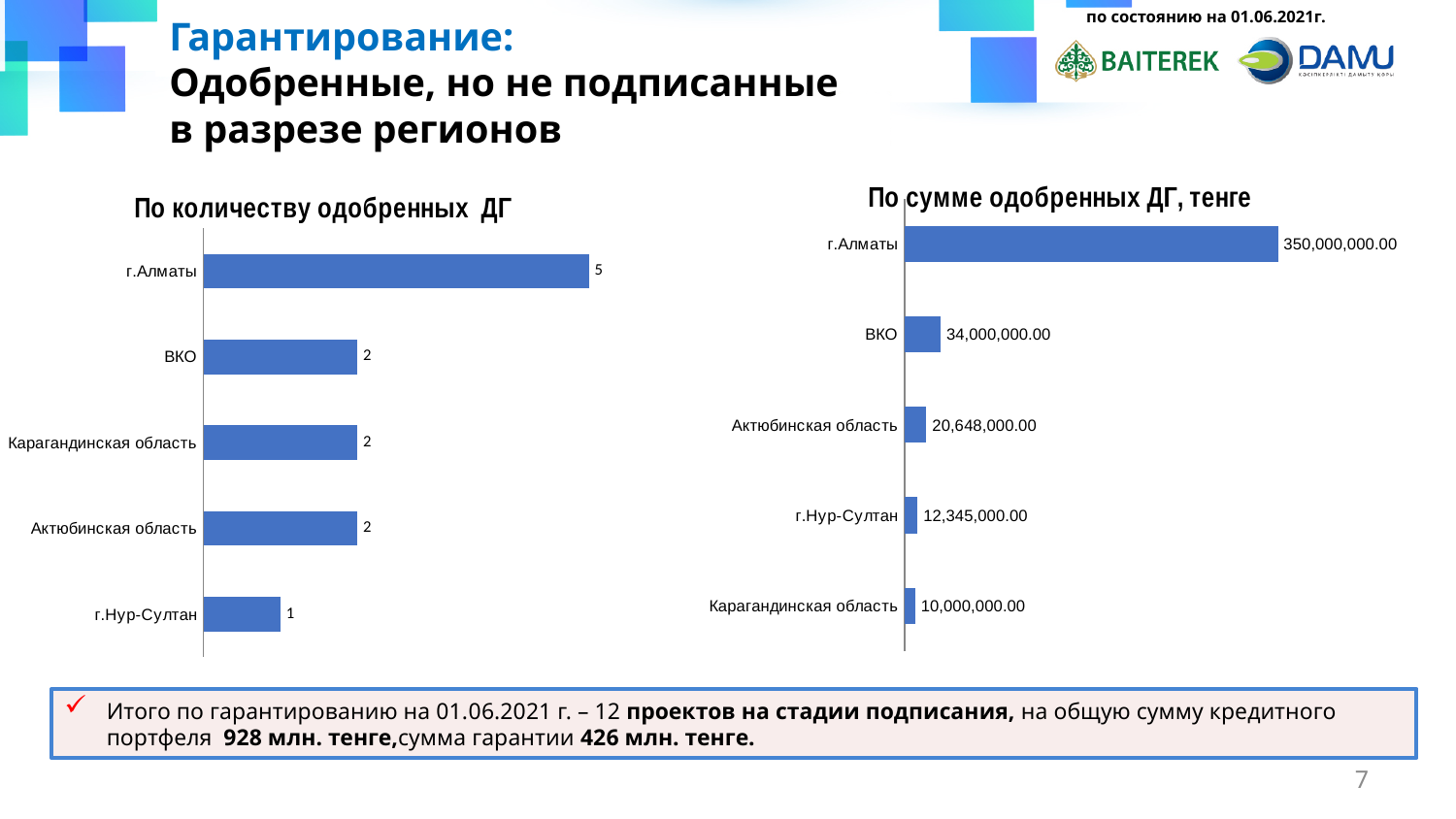
What type of chart is "По сумме одобренных ДГ, тенге"? Bar chart In the chart "По сумме одобренных ДГ, тенге", what is the difference between the values for г.Алматы and ВКО? 316,000,000.00 In the chart "По сумме одобренных ДГ, тенге", what is the value for ВКО? 34,000,000.00 In the chart "По количеству одобренных ДГ", how many categories are shown? 5 In the chart "По сумме одобренных ДГ, тенге", which category has the lowest value? Карагандинская область In the chart "По количеству одобренных ДГ", which category has the lowest value? г.Нур-Султан In the chart "По сумме одобренных ДГ, тенге", what is the value for Актюбинская область? 20,648,000.00 In the chart "По количеству одобренных ДГ", what is the difference between the values for г.Алматы and ВКО? 3 In the chart "По сумме одобренных ДГ, тенге", which is larger: the value for г.Нур-Султан or the value for Карагандинская область? г.Нур-Султан In the chart "По количеству одобренных ДГ", what is the value for г.Алматы? 5 In the chart "По количеству одобренных ДГ", what is the value for г.Нур-Султан? 1 In the chart "По количеству одобренных ДГ", which category has the highest value? г.Алматы